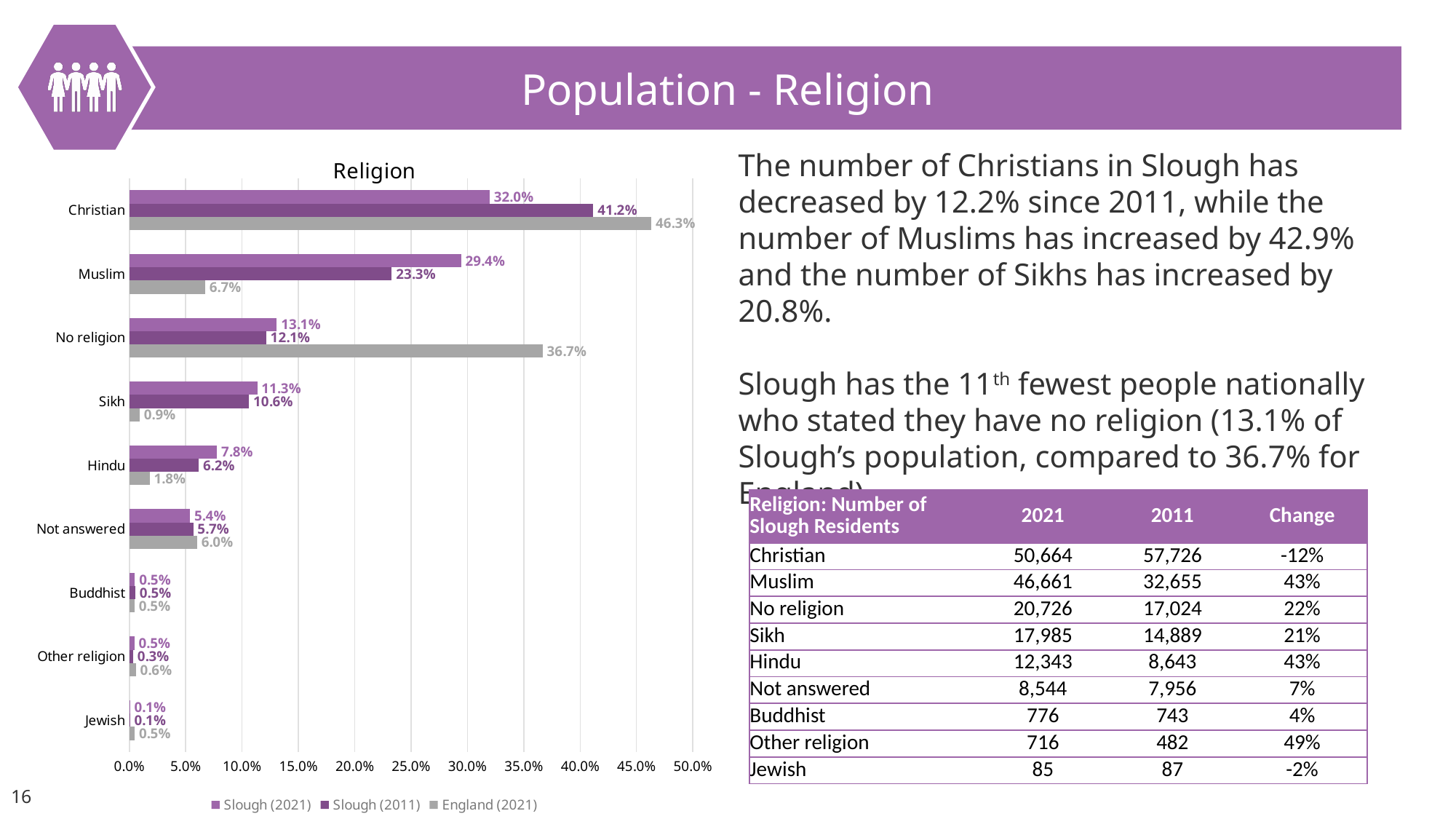
How many series does the legend of the Religion chart list? 3 What is the England (2021) value for No religion in the Religion chart? 36.7% In the Religion chart, which is larger for Sikh: the Slough (2021) value or the England (2021) value? Slough (2021) What is the Slough (2011) value for Muslim in the Religion chart? 23.3% Which category has the lowest Slough (2021) value in the Religion chart? Jewish What type of chart is the Religion chart? Bar chart What is the Slough (2021) value for Christian in the Religion chart? 32.0% Is the England (2021) value for Christian in the Religion chart greater or less than 45.0%? greater What is the difference between the Slough (2021) and England (2021) values for Muslim in the Religion chart? 22.7% Which category has the highest England (2021) value in the Religion chart? Christian What is the difference between the Slough (2011) and Slough (2021) values for Christian in the Religion chart? 9.2% How many religion categories are shown in the Religion chart? 9